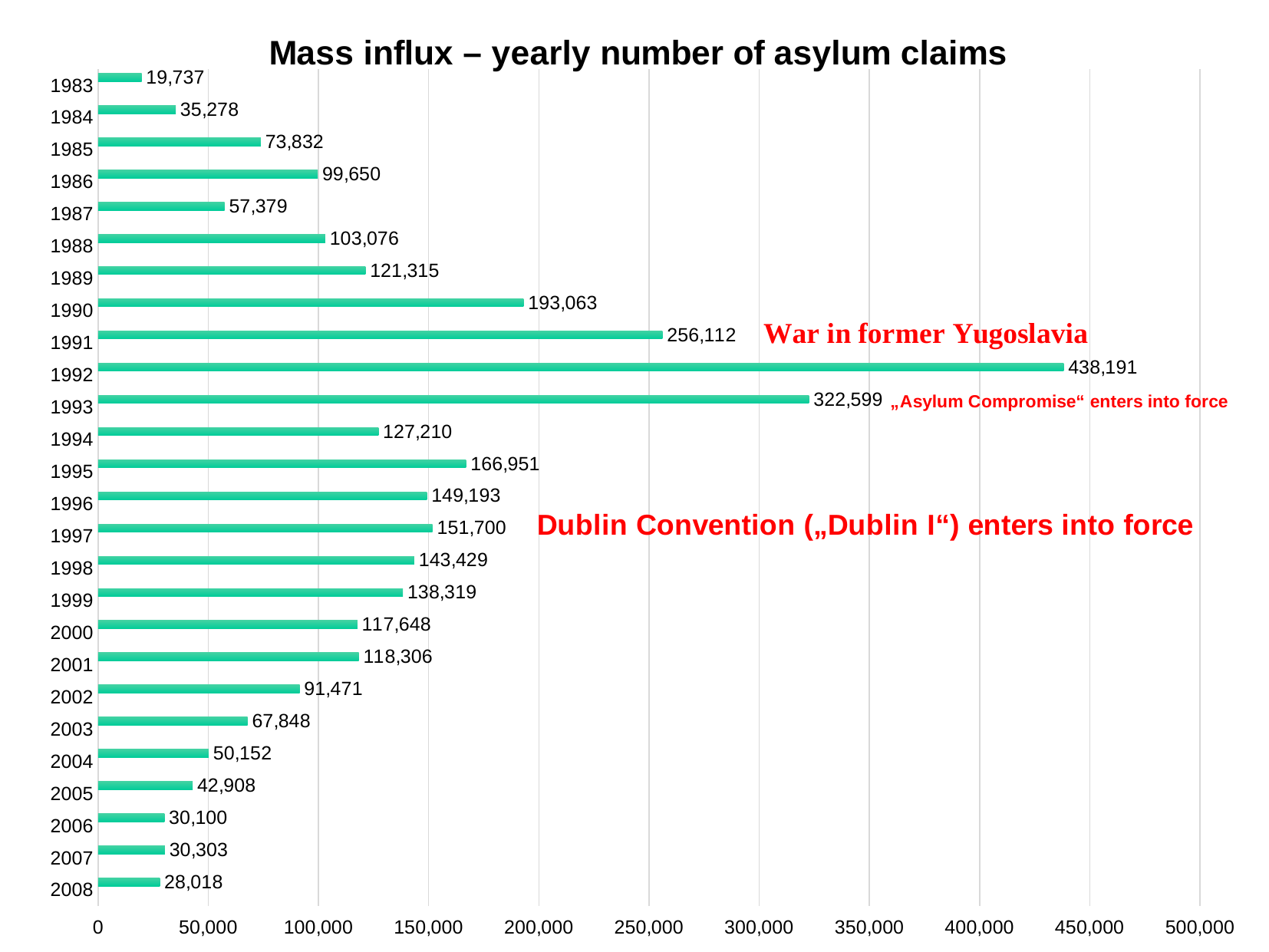
What is the difference between the values for 1992 and 1991? 182,079 Which year has the highest number of asylum claims? 1992 What is the difference between the values for 1993 and 1994? 195,389 What value is shown for 1990? 193,063 What kind of chart is shown on the slide? bar chart What is the number of asylum claims shown for 2008? 28,018 Which year has the larger value, 1995 or 1996? 1995 What is the title of the chart? Mass influx – yearly number of asylum claims What is the number of asylum claims shown for 1992? 438,191 Is the value for 2002 greater or less than 100,000? less How many years are shown on the chart? 26 Which year has the lowest number of asylum claims? 1983